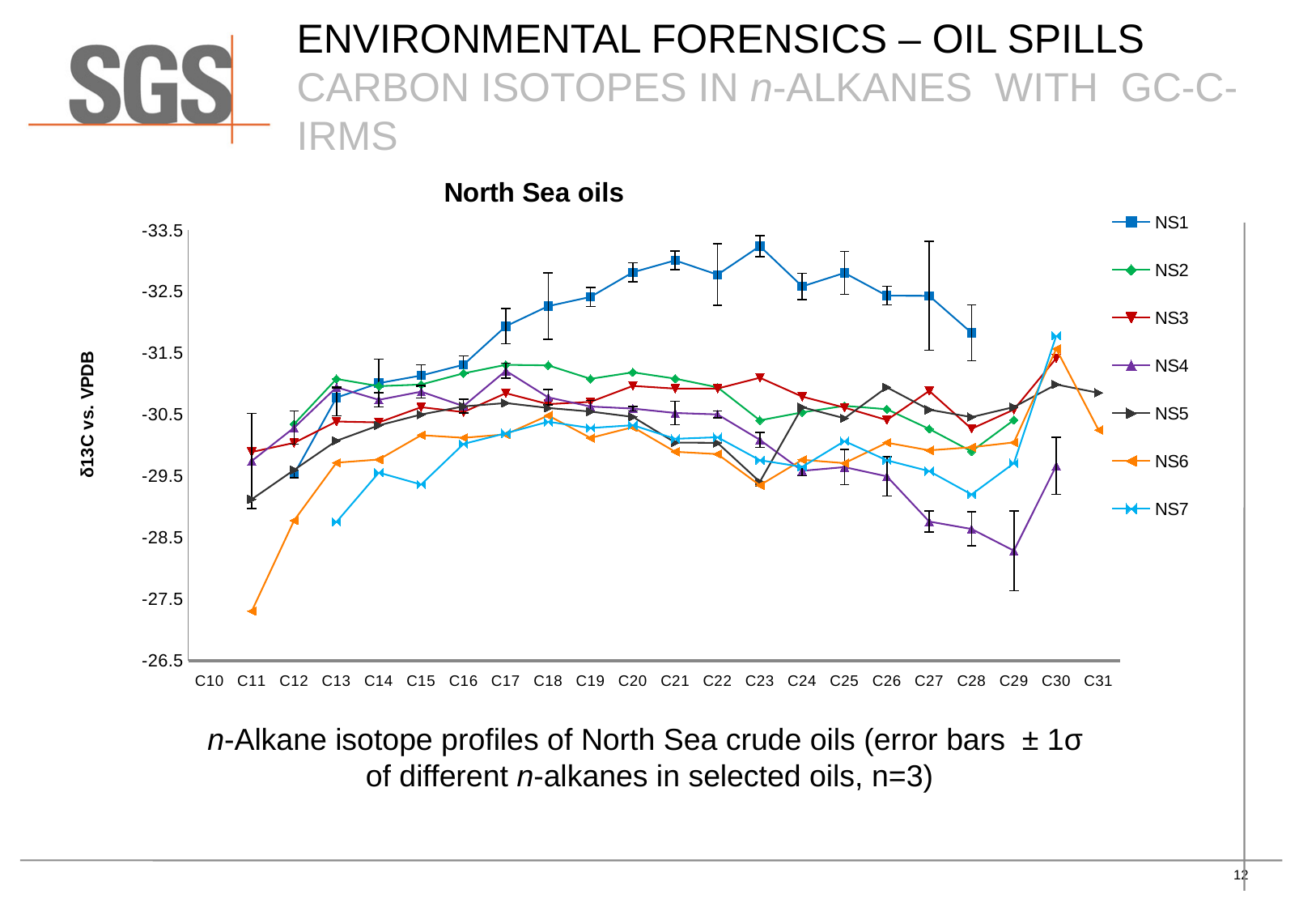
How many categories are labelled on the x axis? 22 Is the value for NS1 at C23 greater or less than -32.5? less Which series has the most negative value at C23? NS1 What kind of chart is shown on the slide? Line chart Which series has the more negative value at C20, NS1 or NS6? NS1 What is the title of the chart? North Sea oils How many series does the legend list? 7 Is the value for NS1 at C17 greater or less than -31.5? less What is the label of the y axis? δ13C vs. VPDB Is the value for NS4 at C29 greater or less than -29.5? greater Which series has the least negative value at C11? NS6